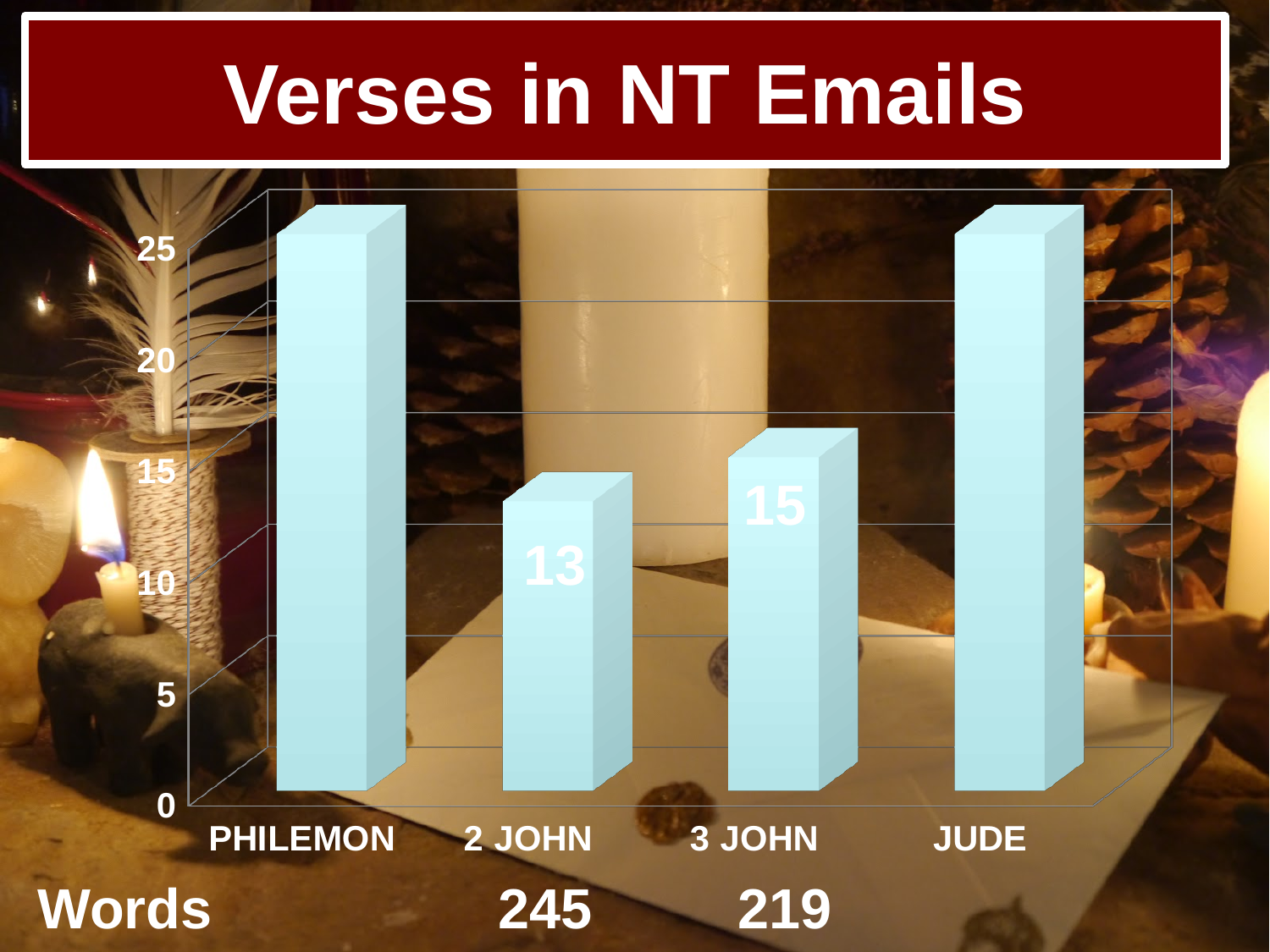
What is the value for 3 John? 15 What is the value for 2 John? 13 What is the difference between the values for 3 John and 2 John? 2 Is the value for Philemon greater or less than 20? greater What is the title of the chart? Verses in NT Emails Which category has the lowest value? 2 John What kind of chart is shown on the slide? bar chart What is the highest value shown on the vertical axis? 25 Is the value for 2 John greater or less than 15? less Which is larger, the value for 2 John or the value for 3 John? 3 John Is the value for Jude greater or less than 20? greater How many categories are shown on the chart? 4